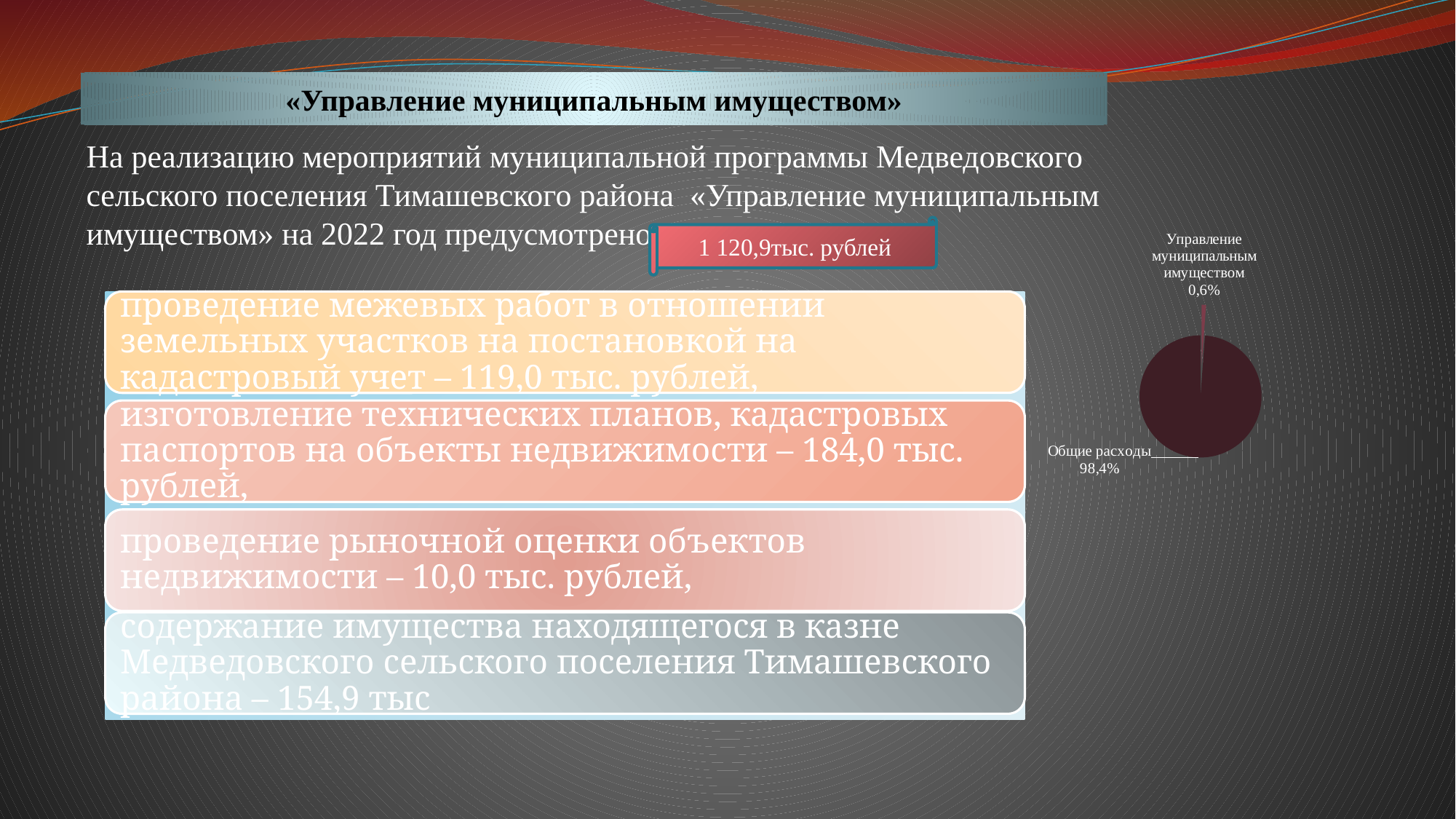
What colour is the large "Общие расходы" slice of the pie chart? dark brown Which is larger in the pie chart: "Общие расходы" or "Управление муниципальным имуществом"? Общие расходы How many slices does the pie chart have? 2 What is the value labelled for the "Управление муниципальным имуществом" slice? 0,6% What is the value labelled for the "Общие расходы" slice? 98,4% Which slice of the pie chart is the smallest? Управление муниципальным имуществом What share of the pie does "Общие расходы" represent? 98,4% What share of the pie does "Управление муниципальным имуществом" represent? 0,6% What is the difference in percentage points between the "Общие расходы" slice and the "Управление муниципальным имуществом" slice? 97,8% Which slice of the pie chart is the largest? Общие расходы What kind of chart is shown on the right side of the slide? pie chart